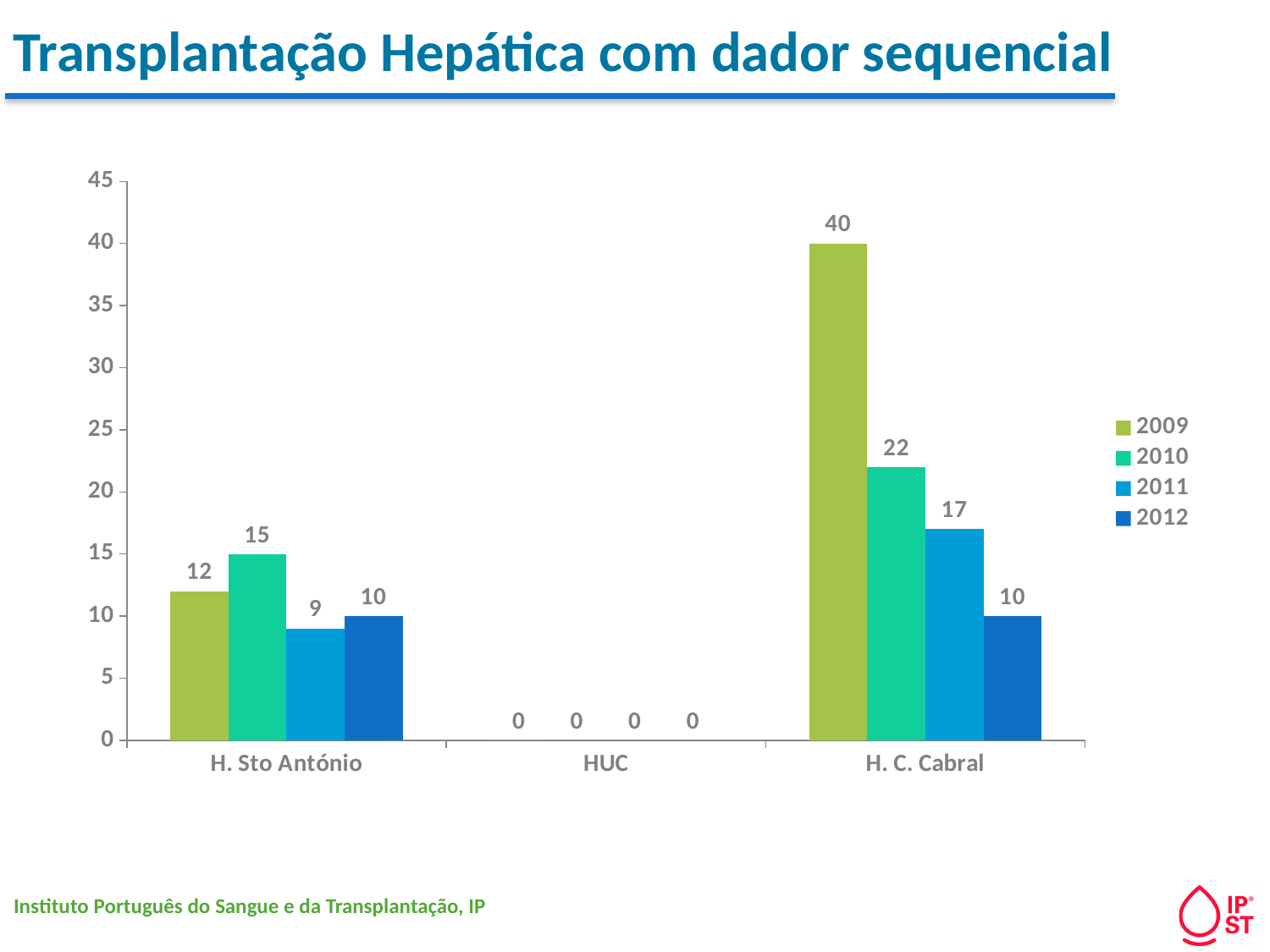
How many hospitals are shown on the x axis? 3 What kind of chart is shown on the slide? bar chart What is the title of the chart? Transplantação Hepática com dador sequencial What is the value for HUC in 2012? 0 What is the value for H. C. Cabral in 2009? 40 Which hospital has the highest value in 2010? H. C. Cabral Which is larger for H. Sto António: the 2010 value or the 2012 value? 2010 What is the difference between the 2009 and 2012 values for H. C. Cabral? 30 How many series does the legend list? 4 Do the values for H. C. Cabral rise or fall from 2009 to 2012? fall What is the value for H. Sto António in 2011? 9 Which hospital has the lowest value in 2009? HUC